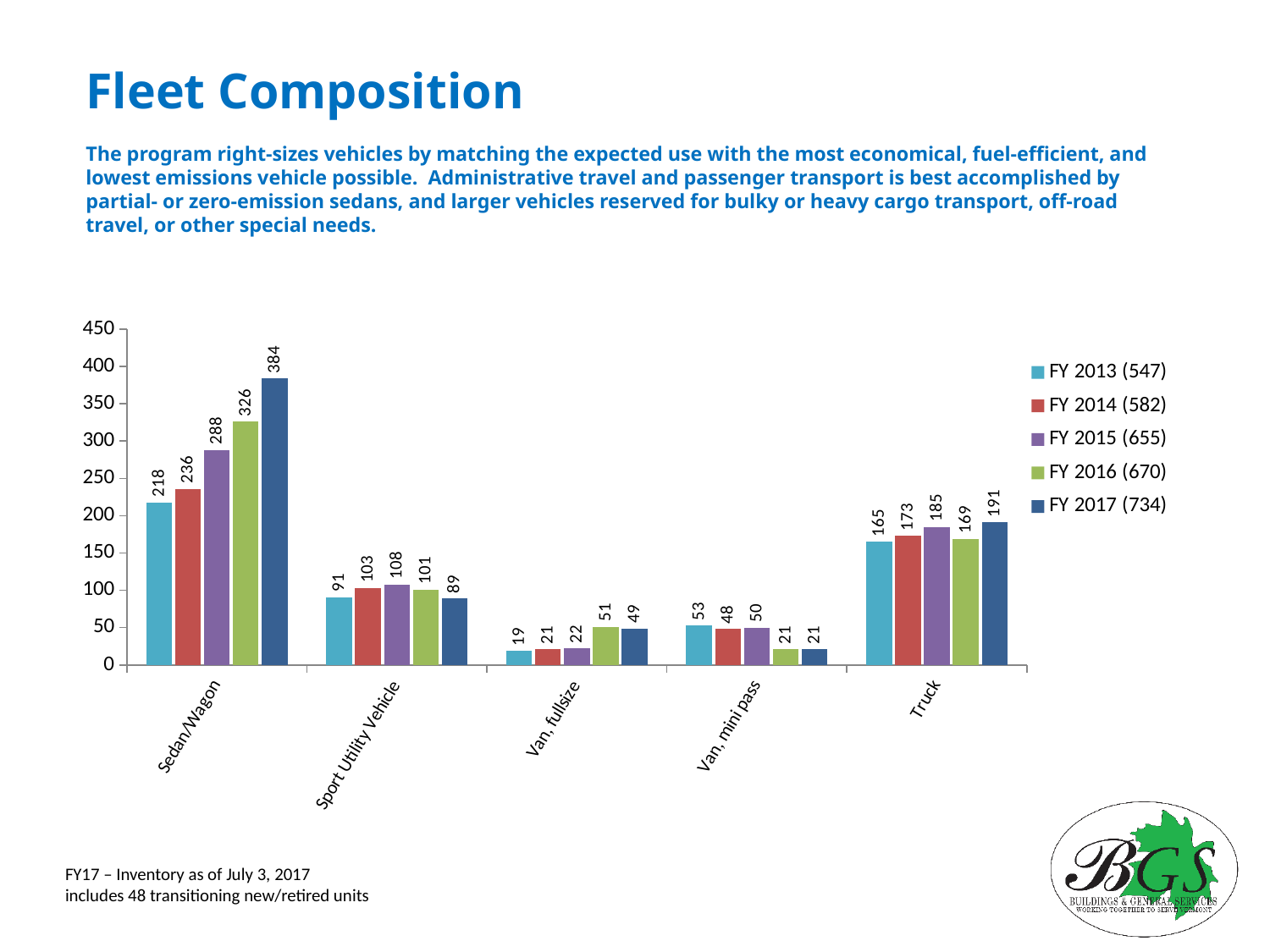
How many vehicle categories are shown on the x axis? 5 Is the value for Truck in FY 2017 (734) greater or less than 150? greater Which category has the lowest value in FY 2013 (547)? Van, fullsize What is the difference between the FY 2017 (734) and FY 2013 (547) values for Sedan/Wagon? 166 How many series does the legend list? 5 Which is larger for Sport Utility Vehicle: the FY 2015 (655) value or the FY 2017 (734) value? FY 2015 (655) Do the Sedan/Wagon values rise or fall from FY 2013 (547) to FY 2017 (734)? rise What is the value for Van, mini pass in FY 2016 (670)? 21 What kind of chart is shown on the slide? bar chart What is the value for Truck in FY 2013 (547)? 165 Which category has the highest value in FY 2015 (655)? Sedan/Wagon What is the value for Sedan/Wagon in FY 2017 (734)? 384